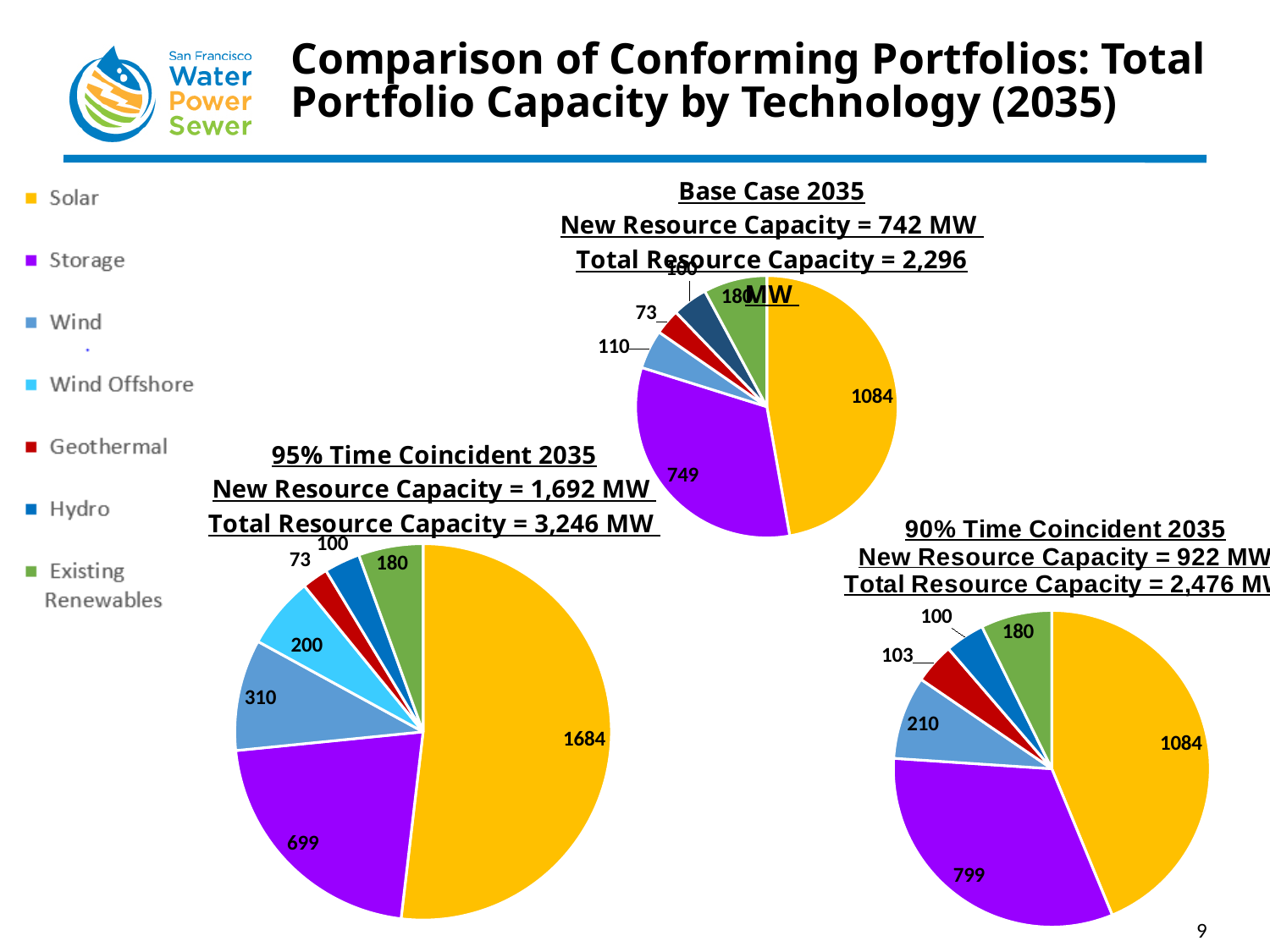
How many slices does the 95% Time Coincident 2035 pie chart have? 7 In the 90% Time Coincident 2035 pie chart, what is the value of the Geothermal slice? 103 Which is larger: the Storage value in the Base Case 2035 chart or the Storage value in the 90% Time Coincident 2035 chart? 90% Time Coincident 2035 In the 90% Time Coincident 2035 pie chart, what is the difference between the Storage and Wind values? 589 In the Base Case 2035 pie chart, which category has the smallest slice? Geothermal In the 95% Time Coincident 2035 pie chart, what is the difference between the Solar and Storage values? 985 How many categories does the legend on the slide list? 7 In the 90% Time Coincident 2035 pie chart, what is the value of the Wind slice? 210 In the 95% Time Coincident 2035 pie chart, what is the value of the Storage slice? 699 In the 95% Time Coincident 2035 pie chart, which category has the largest slice? Solar What kind of chart is used to show the Base Case 2035 portfolio? Pie chart In the Base Case 2035 pie chart, what is the value of the Solar slice? 1084